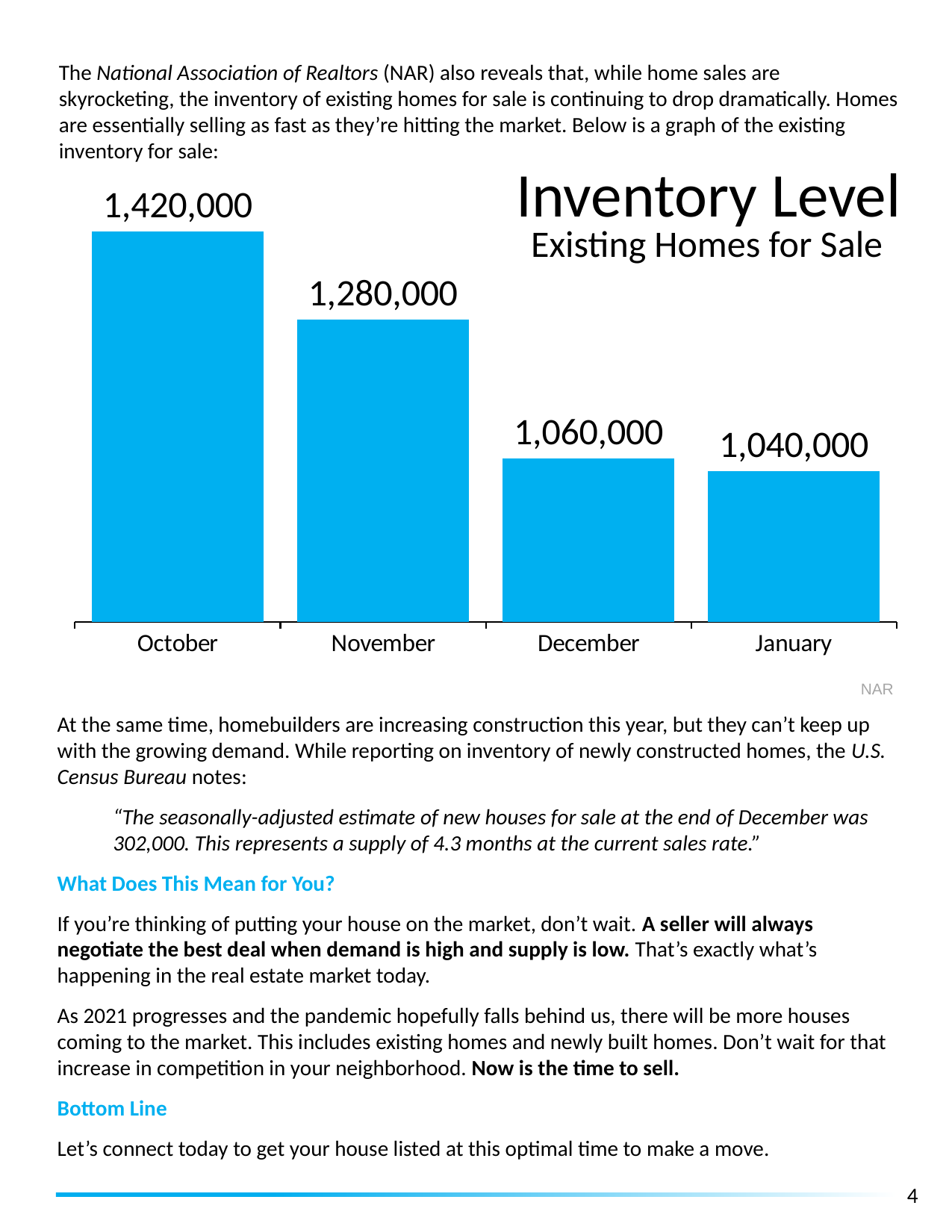
Which is larger, the inventory level for November or for December? November What is the difference between the December and January inventory levels? 20,000 What is the inventory level for October? 1,420,000 Do the inventory levels rise or fall from October to January? Fall Which month has the highest inventory level? October What is the inventory level for November? 1,280,000 Which month has the lowest inventory level? January What is the inventory level for January? 1,040,000 What kind of chart is shown on the slide? Bar chart How many months are shown on the chart? 4 What is the inventory level for December? 1,060,000 What is the difference between the October and November inventory levels? 140,000